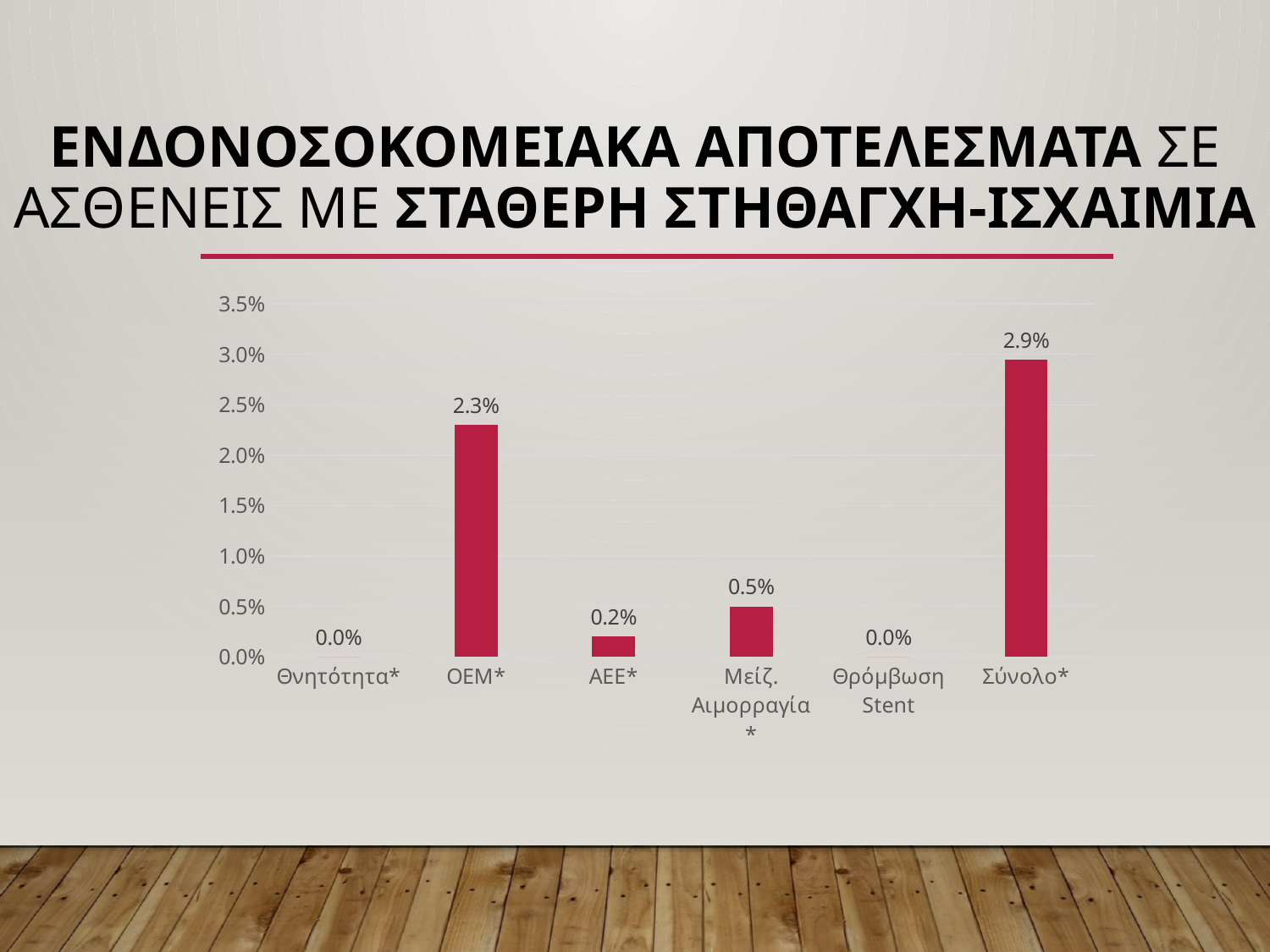
What is the value for ΑΕΕ*? 0.2% What is the value for Μείζ. Αιμορραγία*? 0.5% Is the value for ΟΕΜ* greater or less than 2.0%? greater How many categories have a value of 0.0%? 2 What is the difference between the values for Σύνολο* and ΟΕΜ*? 0.6% How many categories are shown on the x axis? 6 What is the value for Σύνολο*? 2.9% Which category has the highest value? Σύνολο* What kind of chart is shown on the slide? bar chart What is the value for Θρόμβωση Stent? 0.0% Which is larger, the value for ΑΕΕ* or the value for Μείζ. Αιμορραγία*? Μείζ. Αιμορραγία* What is the value for ΟΕΜ*? 2.3%